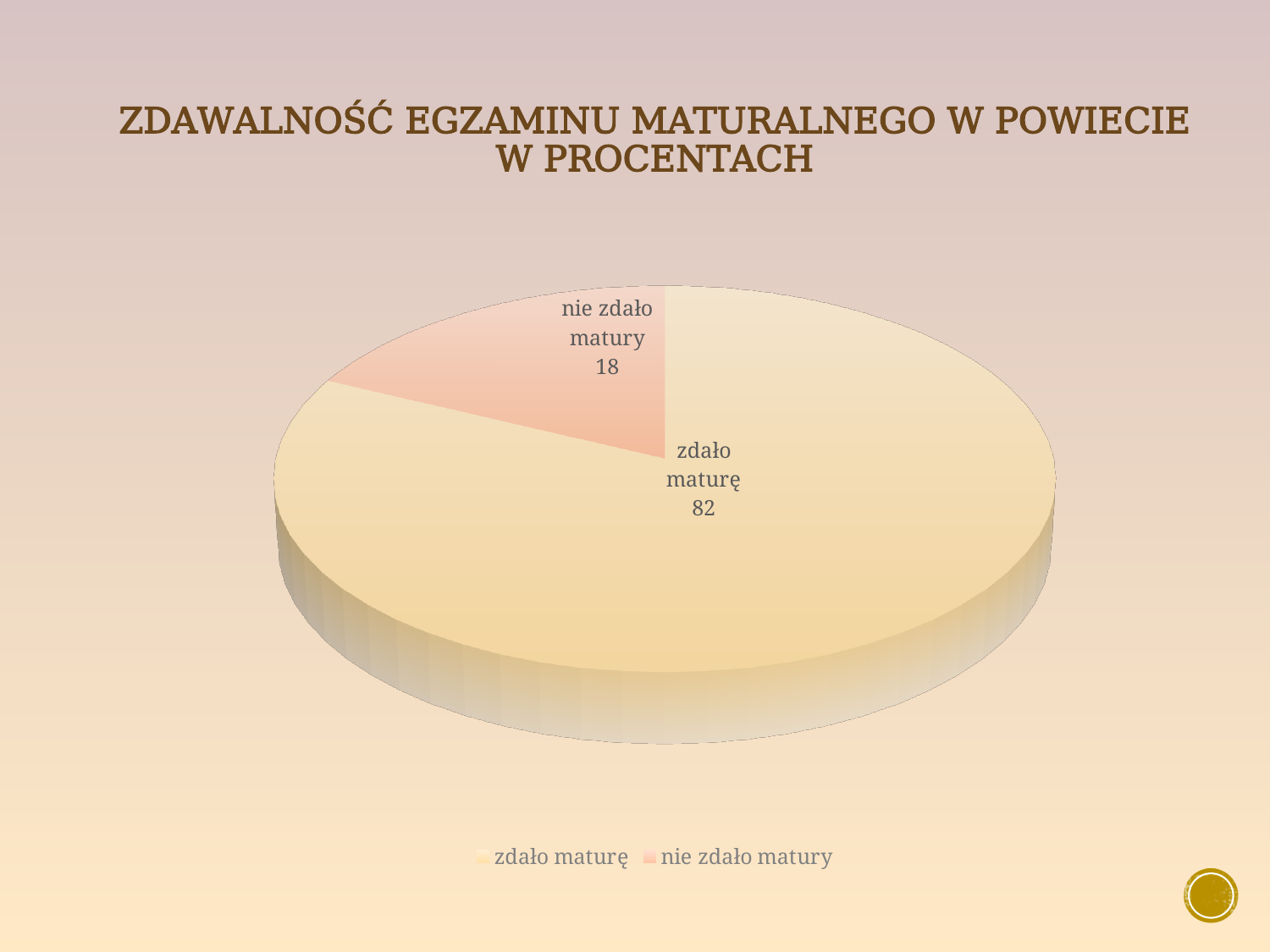
What is the title of the chart on the slide? ZDAWALNOŚĆ EGZAMINU MATURALNEGO W POWIECIE W PROCENTACH Which legend entry is shown in the pink/salmon colour? nie zdało matury Which is larger: the value for "zdało maturę" or for "nie zdało matury"? zdało maturę Which slice is the largest? zdało maturę What is the total of the two slice values? 100 What is the difference between the values for "zdało maturę" and "nie zdało matury"? 64 Which slice is the smallest? nie zdało matury What value is shown for the "nie zdało matury" slice? 18 How many entries does the legend list? 2 What kind of chart is shown on the slide? pie chart How many slices does the pie chart have? 2 What value is shown for the "zdało maturę" slice? 82